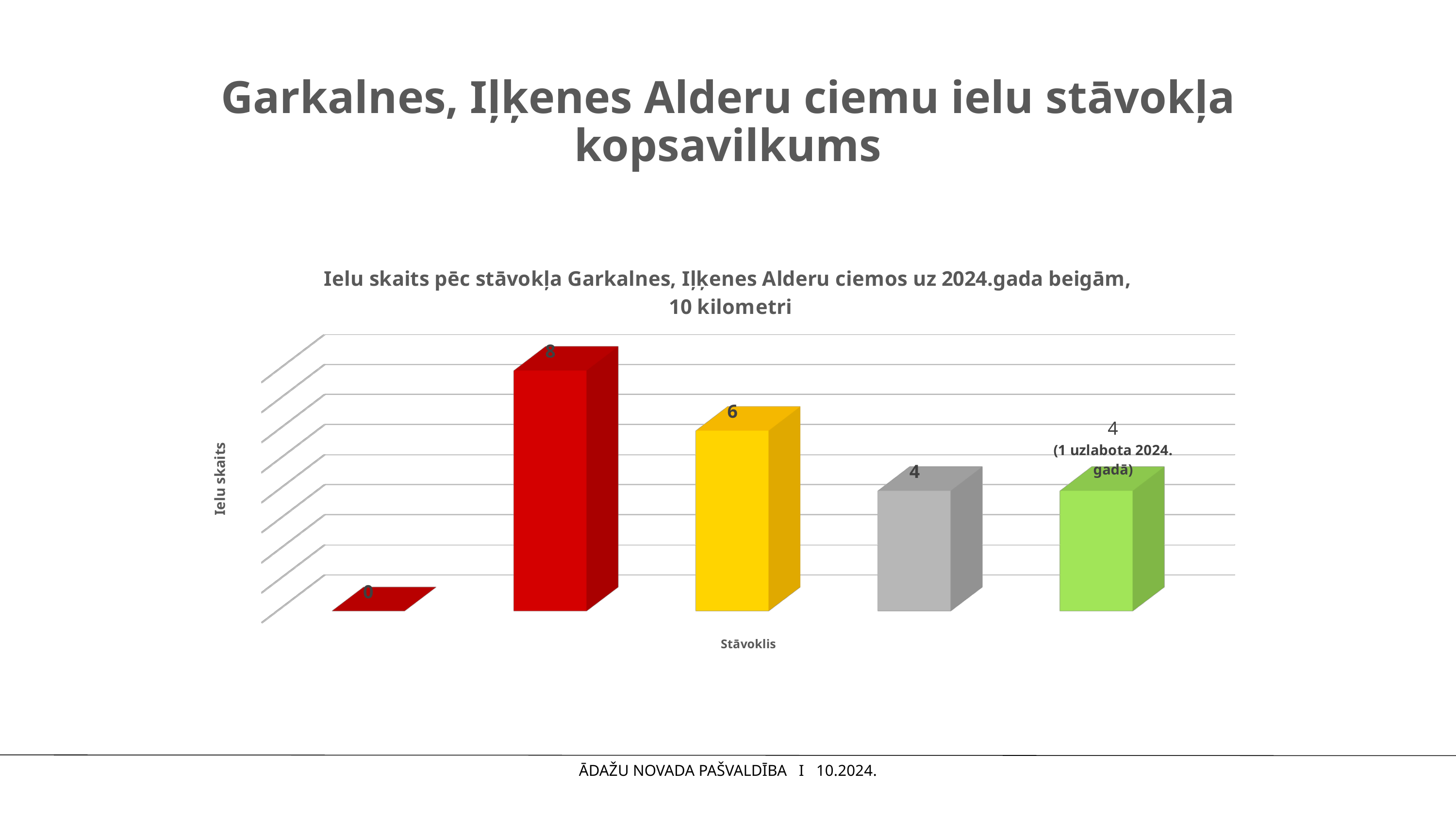
How many bars are plotted in the chart? 5 What is the value shown on the yellow bar? 6 Which bar has the lowest value? the leftmost dark red bar, 0 What is the value shown on the grey bar? 4 What kind of chart is shown on the slide? bar chart What is the title of the chart? Ielu skaits pēc stāvokļa Garkalnes, Iļķenes Alderu ciemos uz 2024.gada beigām, 10 kilometri What is the label of the vertical axis? Ielu skaits Which bar has the highest value? the red bar (second from the left), 8 What is the difference between the red bar's value and the yellow bar's value? 2 Which is larger, the value of the yellow bar or the value of the grey bar? the yellow bar What is the value shown on the red bar (second from the left)? 8 What is the value shown on the leftmost (dark red) bar? 0